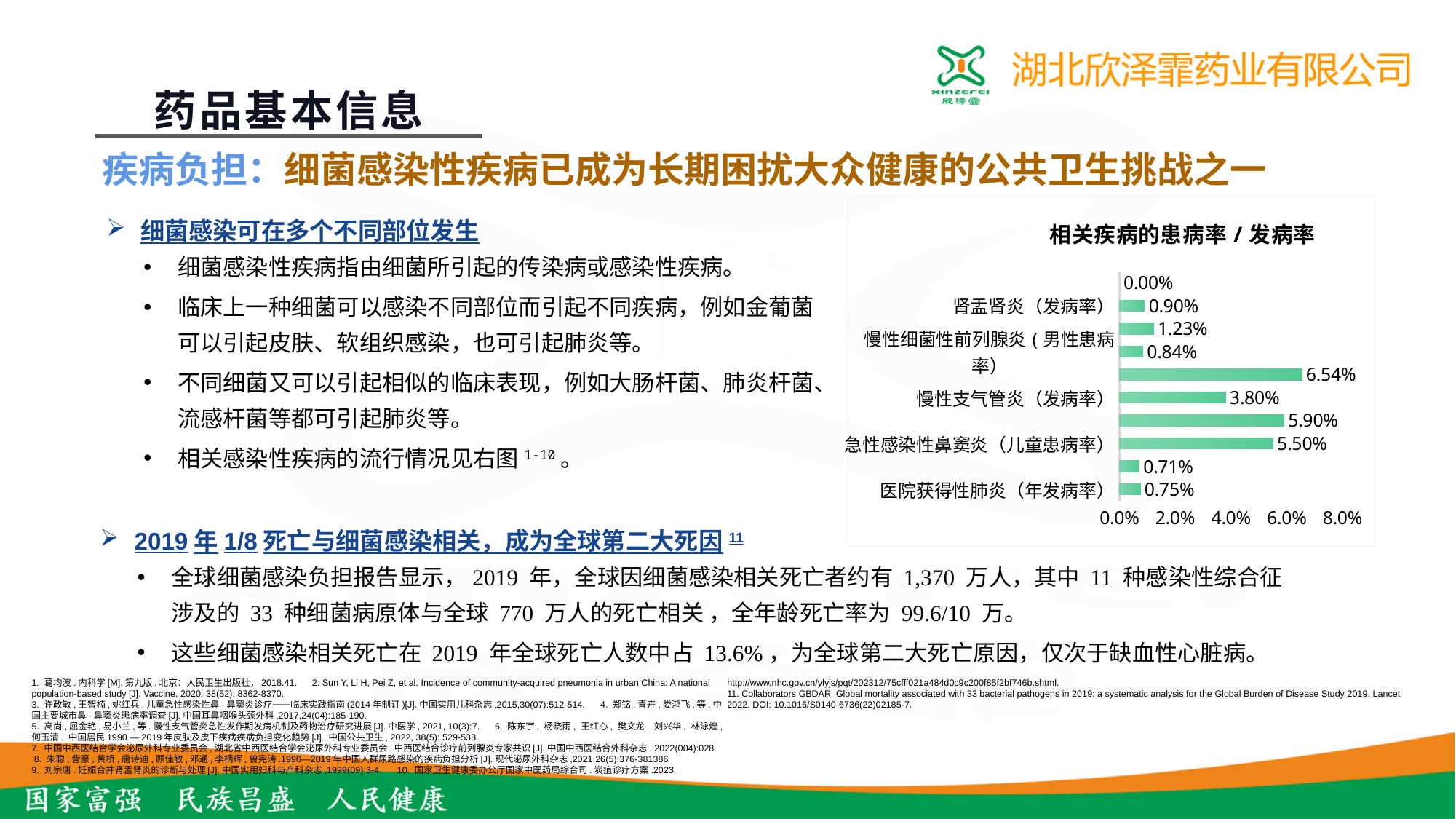
How many bars are plotted on the chart? 10 What is the largest value labeled on the chart? 6.54% What is the title of the chart on the slide? 相关疾病的患病率 / 发病率 What is the difference between the two largest labeled values on the chart, 6.54% and 5.90%? 0.64% How many category labels are shown on the vertical axis of the chart? 5 How many bars on the chart have values greater than 4.0%? 3 What is the highest tick value shown on the horizontal axis of the chart? 8.0% What is the smallest value labeled on the chart? 0.00% What kind of chart is shown on the slide? bar chart Which is larger on the chart, the bar labeled 5.90% or the bar labeled 5.50%? 5.90% What value is labeled on the bar aligned with 肾盂肾炎（发病率）? 0.90% Is the longest bar on the chart greater or less than 6.0%? greater